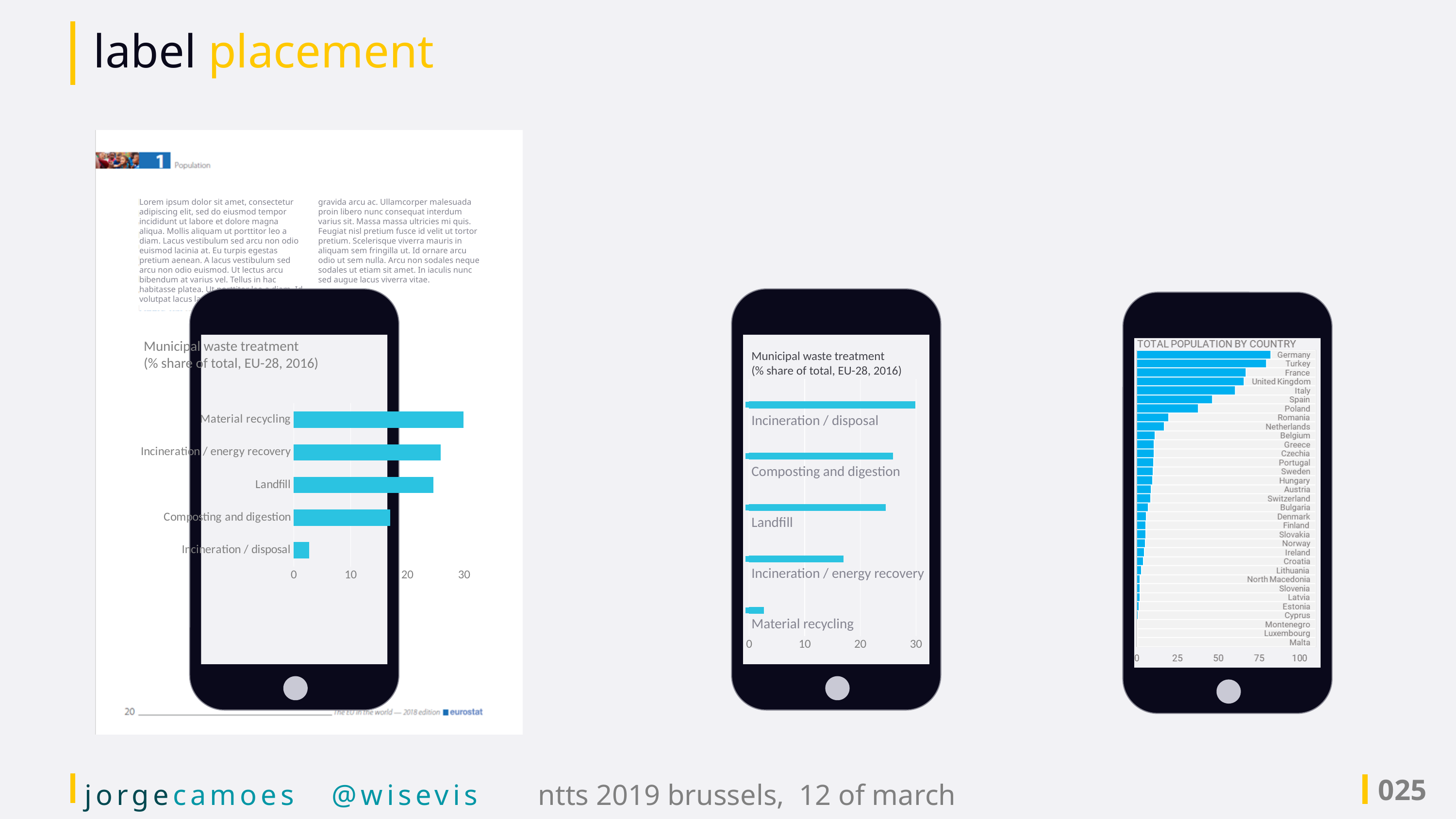
In the Municipal waste treatment chart on the left phone, how many categories are plotted? 5 What kind of chart is shown on the left phone (Municipal waste treatment)? bar chart What is the title of the chart on the right phone? TOTAL POPULATION BY COUNTRY In the Municipal waste treatment chart on the left phone, which category has the highest value? Material recycling In the Municipal waste treatment chart on the left phone, is the value for Material recycling greater or less than 20? greater In the TOTAL POPULATION BY COUNTRY chart on the right phone, which country has the lowest value? Malta In the TOTAL POPULATION BY COUNTRY chart on the right phone, is the value for Poland greater or less than 50? less In the Municipal waste treatment chart on the left phone, which is larger: Landfill or Composting and digestion? Landfill In the Municipal waste treatment chart on the left phone, which category has the lowest value? Incineration / disposal In the Municipal waste treatment chart on the left phone, is the value for Incineration / disposal greater or less than 10? less In the TOTAL POPULATION BY COUNTRY chart on the right phone, which country has the highest value? Germany